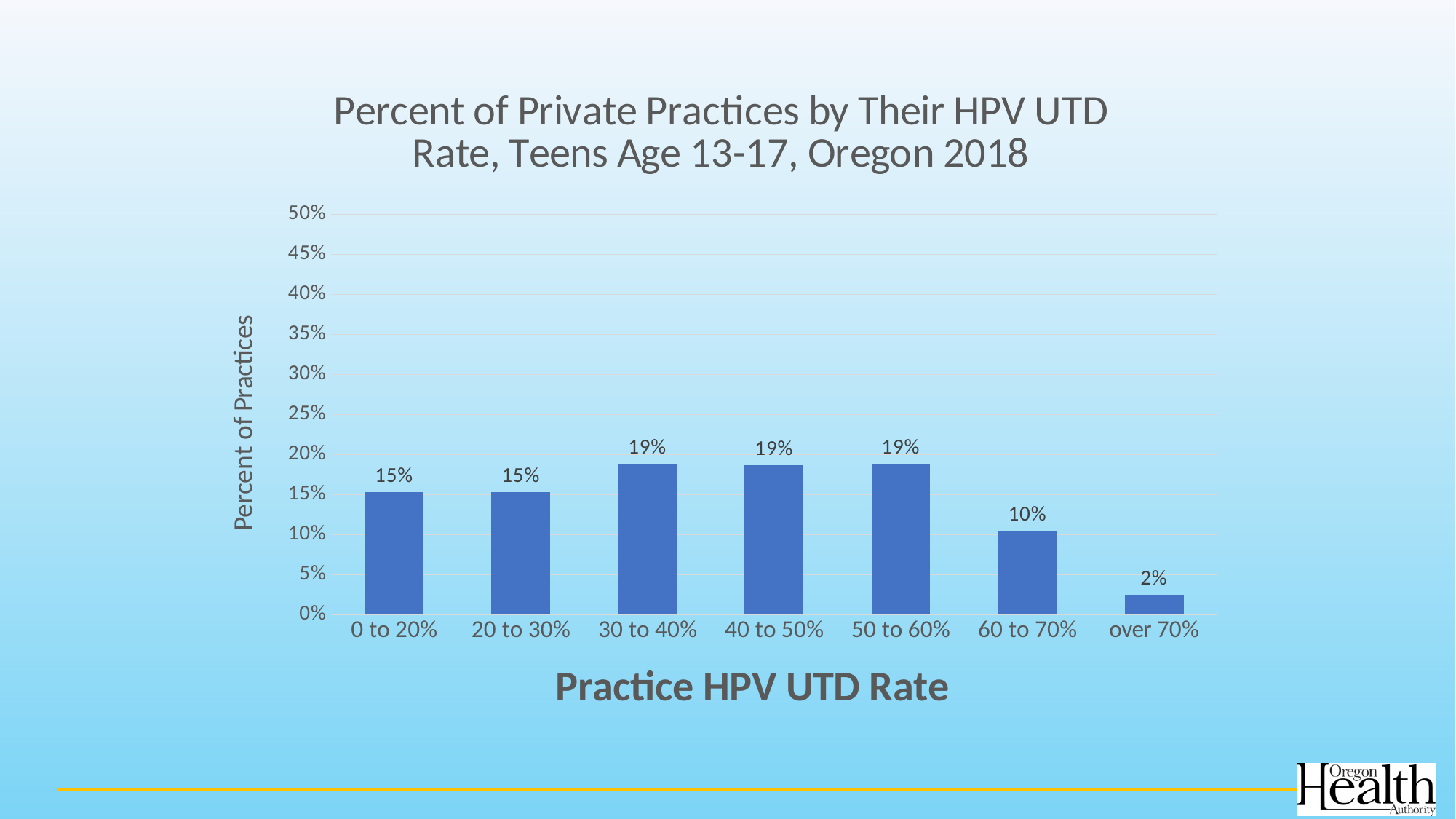
Which is larger, the value for 20 to 30% or the value for 40 to 50%? 40 to 50% What is the value for the 60 to 70% category? 10% What is the difference between the values for 50 to 60% and 60 to 70%? 9% What percent of private practices have an HPV UTD rate of 0 to 20%? 15% How many HPV UTD rate categories are shown on the x axis? 7 Is the value for 60 to 70% greater or less than 15%? less What is the value for the 30 to 40% category? 19% What is the label of the x axis? Practice HPV UTD Rate What percent of practices have an HPV UTD rate over 70%? 2% What kind of chart is shown on the slide? bar chart Which category has the lowest percent of practices? over 70% What is the difference between the values for 30 to 40% and 0 to 20%? 4%